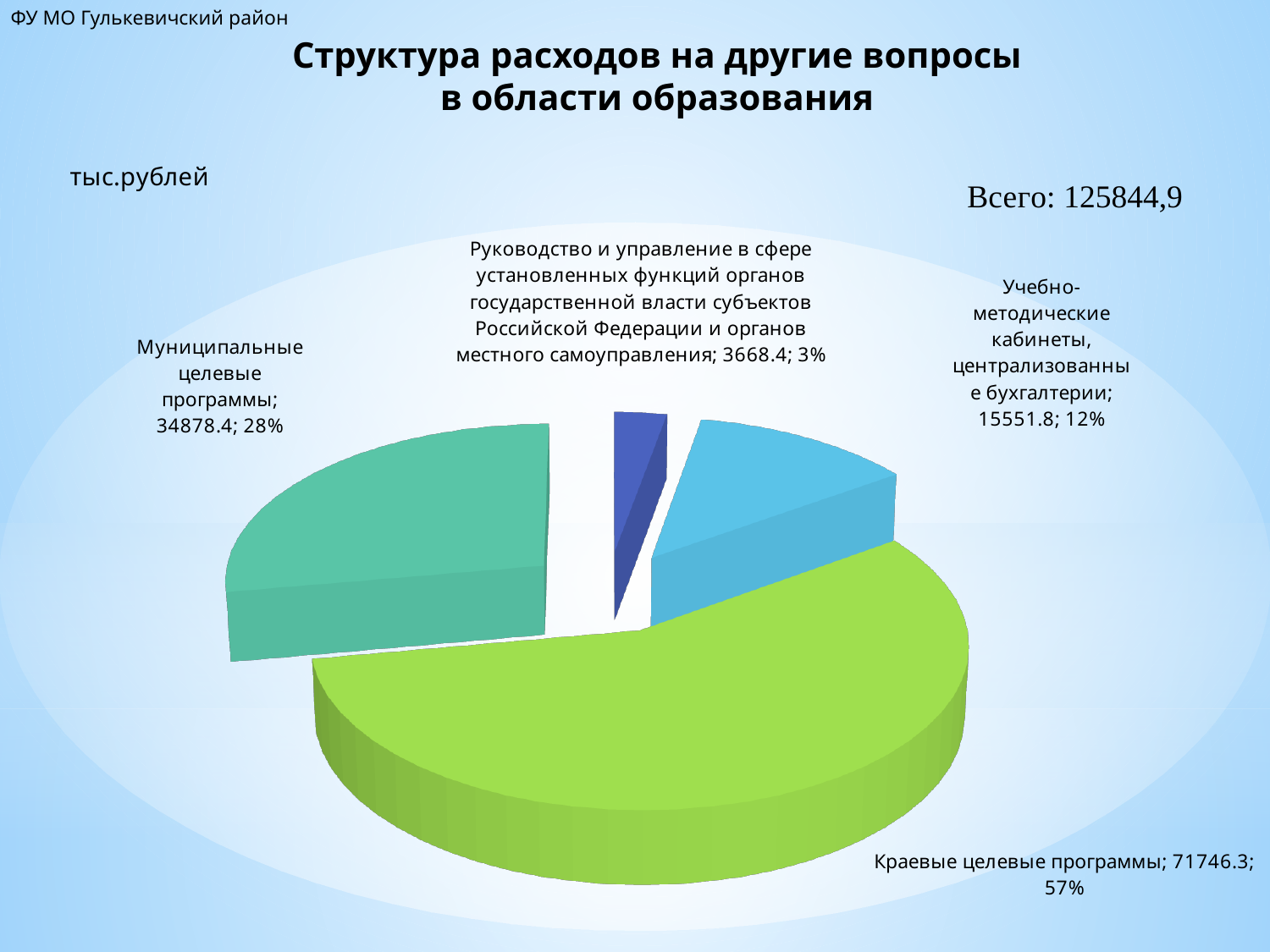
Which category has the smallest share of the pie? Руководство и управление в сфере установленных функций органов государственной власти субъектов Российской Федерации и органов местного самоуправления What type of chart is shown on the slide? Pie chart What is the value for Учебно-методические кабинеты, централизованные бухгалтерии? 15551.8 What is the value for Руководство и управление в сфере установленных функций органов государственной власти субъектов Российской Федерации и органов местного самоуправления? 3668.4 What is the value for Краевые целевые программы? 71746.3 Which category has the largest share of the pie? Краевые целевые программы What share of the pie does Муниципальные целевые программы represent? 28% What is the value for Муниципальные целевые программы? 34878.4 Which is larger: Муниципальные целевые программы or Учебно-методические кабинеты, централизованные бухгалтерии? Муниципальные целевые программы How many slices does the pie chart have? 4 What total (Всего) is shown on the slide? 125844,9 What share of the pie does Учебно-методические кабинеты, централизованные бухгалтерии represent? 12%